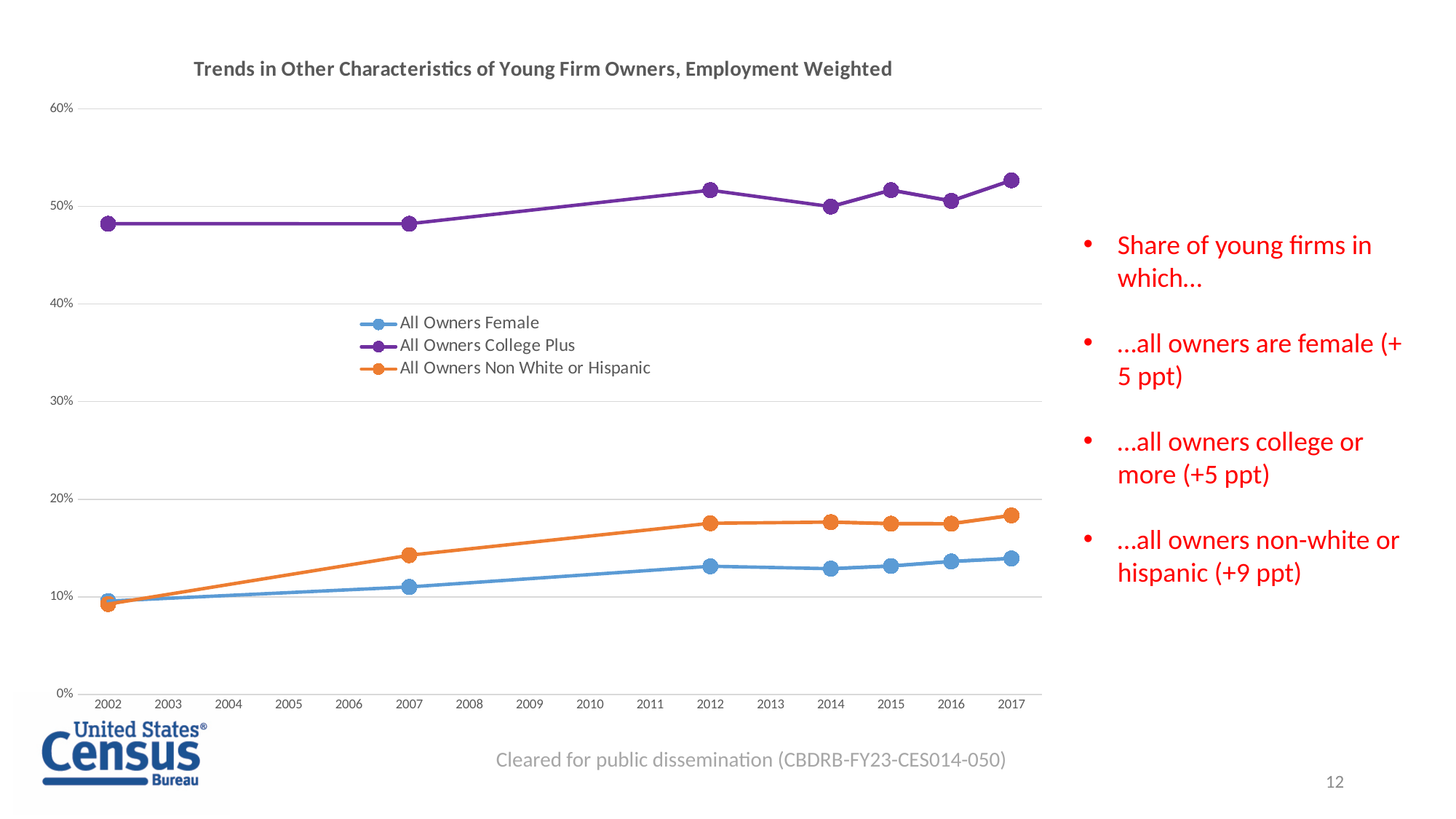
Is the value for All Owners Non White or Hispanic in 2012 greater or less than 10%? greater Is the value for All Owners Female in 2002 greater or less than 20%? less Which series has the lowest value in 2017? All Owners Female What is the title of the chart? Trends in Other Characteristics of Young Firm Owners, Employment Weighted Do the values for All Owners Non White or Hispanic rise or fall from 2002 to 2017? rise How many series does the legend list? 3 Which series has the highest values across all years shown? All Owners College Plus Is the value for All Owners College Plus in 2017 greater or less than 50%? greater How many data points are plotted for each series? 7 In 2017, which is higher: All Owners Female or All Owners Non White or Hispanic? All Owners Non White or Hispanic What kind of chart is shown on the slide? line chart